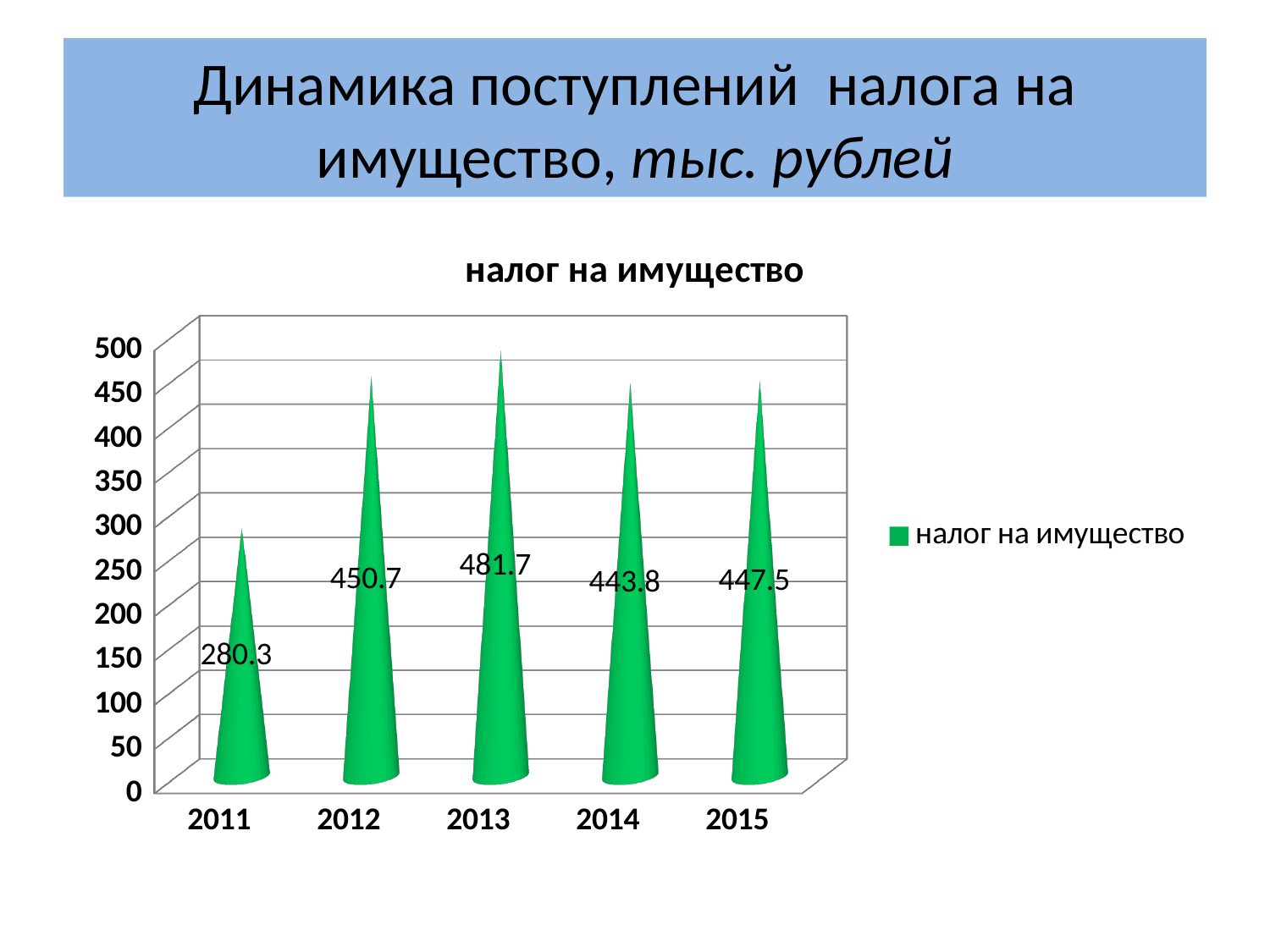
How many series does the legend list? 1 What is the difference between the values for 2013 and 2011? 201.4 What is the value for 2013? 481.7 What is the value for 2015? 447.5 Which is larger, the value for 2011 or the value for 2012? 2012 What is the difference between the values for 2012 and 2014? 6.9 Which year has the lowest value? 2011 Which year has the highest value? 2013 Do the values rise or fall from 2011 to 2013? rise What is the value for 2011? 280.3 How many years are shown on the x axis? 5 Is the value for 2011 greater or less than 300? less